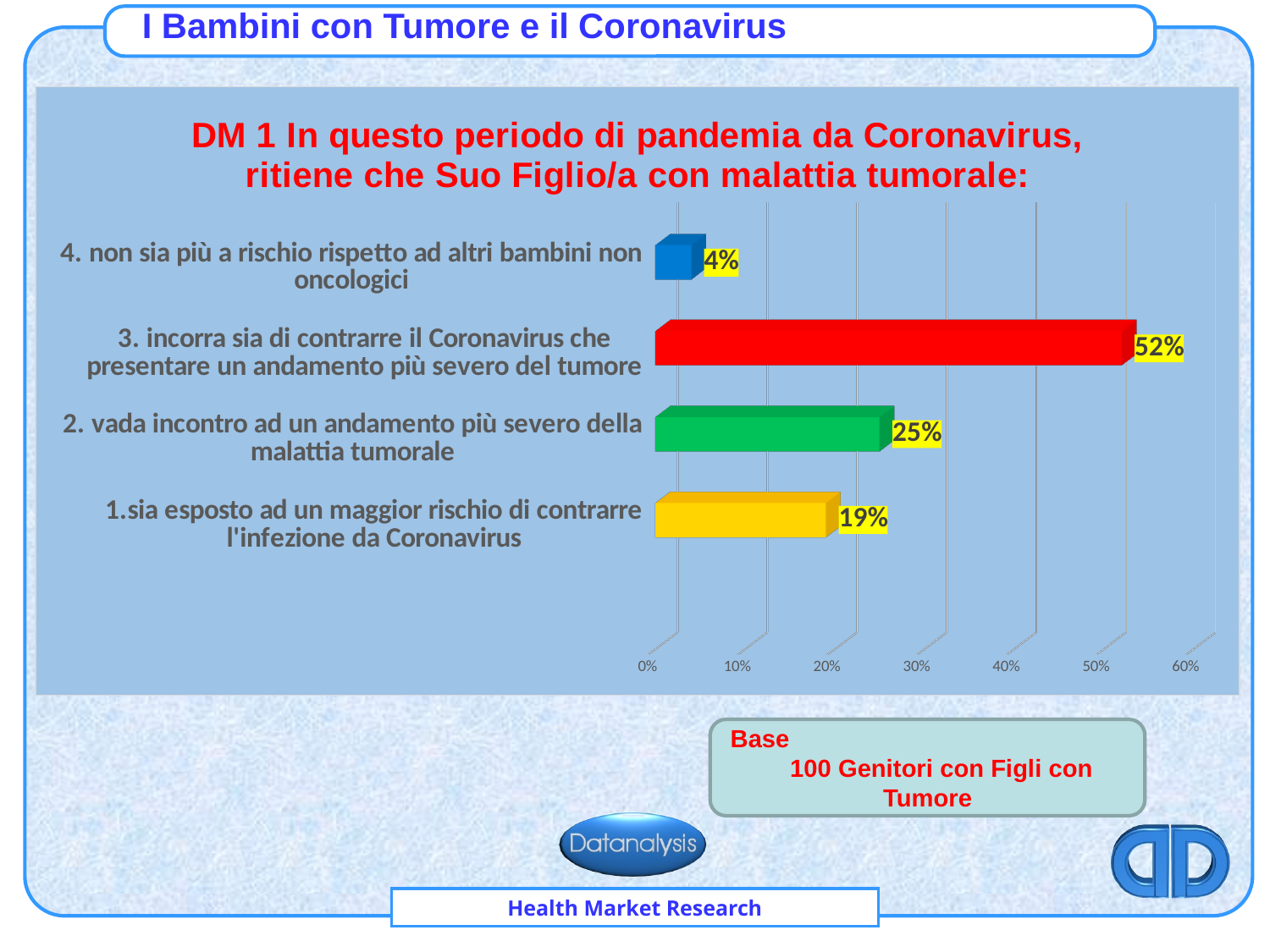
How many categories are shown in the chart? 4 What colour is the bar for category 3? red What is the value for "4. non sia più a rischio rispetto ad altri bambini non oncologici"? 4% What is the difference between the values for category 2 and category 1? 6% Which category has the highest value? 3. incorra sia di contrarre il Coronavirus che presentare un andamento più severo del tumore What is the difference between the values for category 3 and category 2? 27% What is the value for "2. vada incontro ad un andamento più severo della malattia tumorale"? 25% What is the value for "3. incorra sia di contrarre il Coronavirus che presentare un andamento più severo del tumore"? 52% Which category has the lowest value? 4. non sia più a rischio rispetto ad altri bambini non oncologici What is the value for "1.sia esposto ad un maggior rischio di contrarre l'infezione da Coronavirus"? 19% Which is larger: the value for category 1 or the value for category 2? category 2 What kind of chart is shown on the slide? bar chart